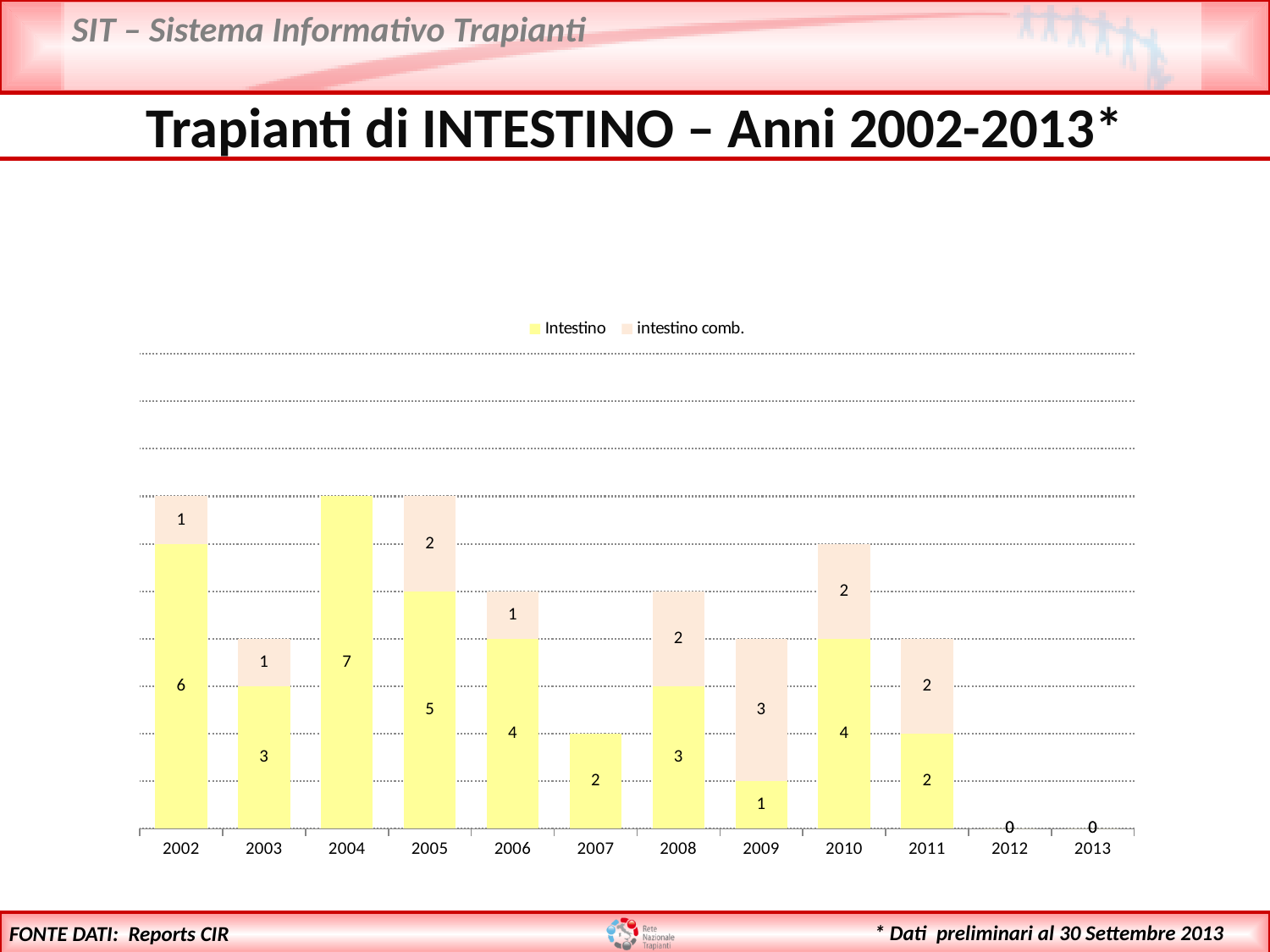
Which year has the highest intestino comb. value? 2009 What is the total of the stacked bar for 2010? 6 How many years are shown on the x axis? 12 What is the intestino comb. value for 2009? 3 What is the difference between the Intestino values for 2002 and 2003? 3 What is the Intestino value for 2002? 6 Which is larger, the Intestino value for 2006 or for 2008? 2006 What is the Intestino value for 2007? 2 How many series does the legend list? 2 What is the total of the stacked bar for 2005? 7 Which year has the highest Intestino value? 2004 What type of chart is shown on the slide? stacked bar chart